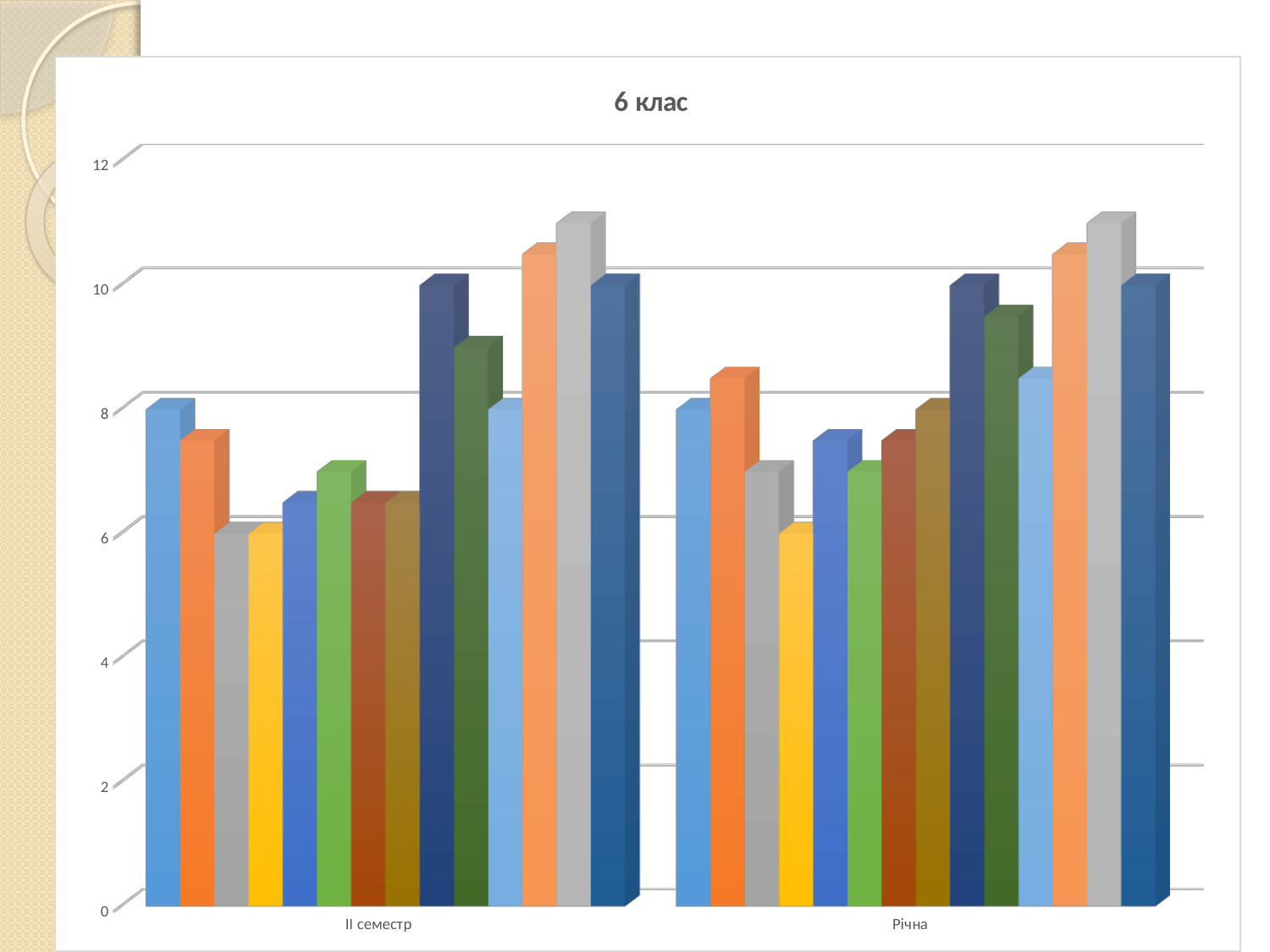
What is the title of the chart? 6 клас Is the tallest bar in the Річна group greater or less than 12? less What are the two category labels on the x axis? ІІ семестр, Річна Is the shortest bar in the ІІ семестр group greater or less than 4? greater How many bars are plotted in the ІІ семестр group? 14 What is the highest value shown on the vertical axis? 12 Is the tallest bar in the ІІ семестр group greater or less than 10? greater What kind of chart is shown on the slide? bar chart How many bars are plotted in the Річна group? 14